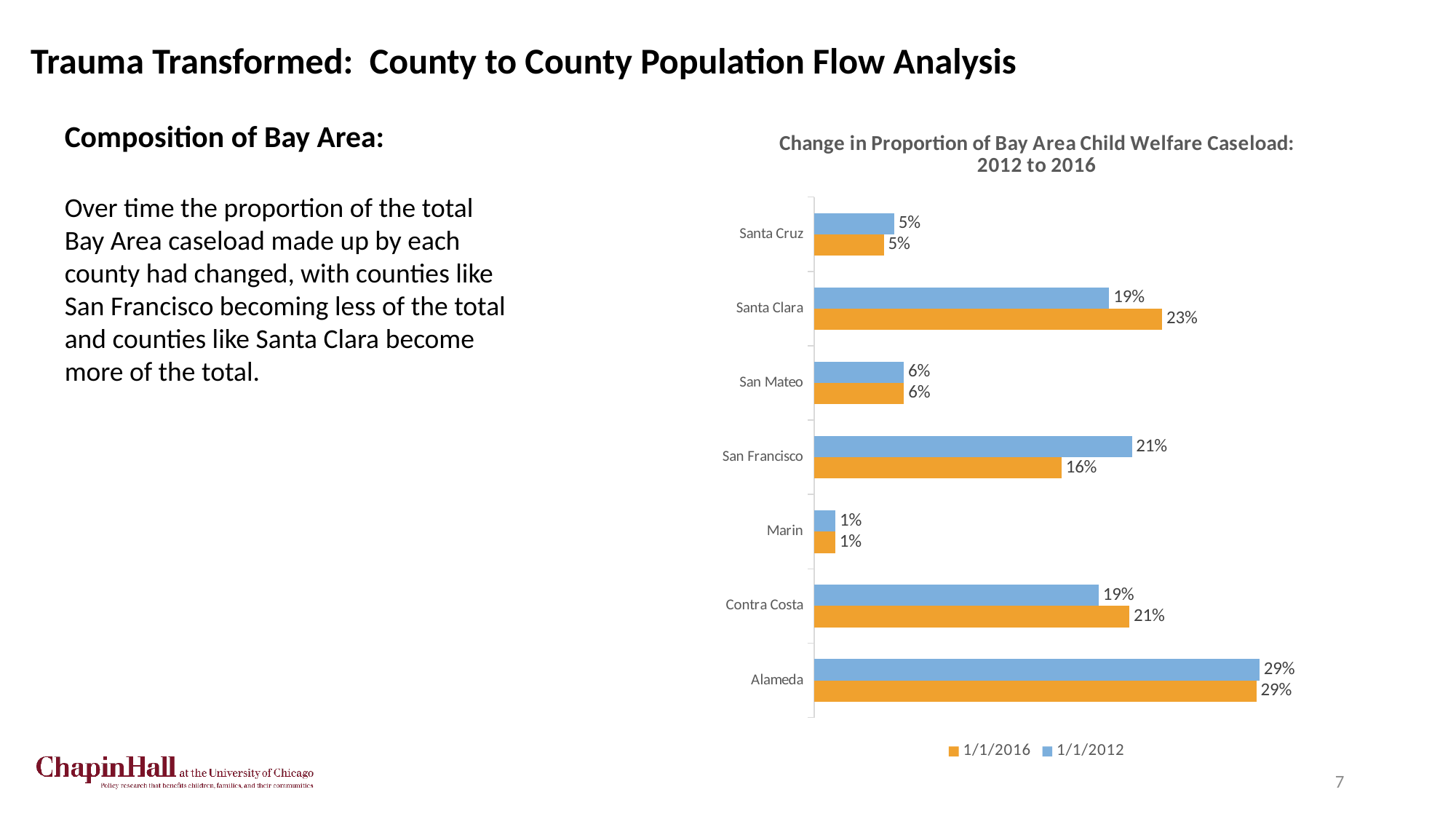
What is the 1/1/2016 value for Santa Clara? 23% How many counties are shown on the chart? 7 How many series does the legend list? 2 Which colour represents the 1/1/2016 series? Orange Which county has the lowest 1/1/2012 value? Marin Which county has the highest 1/1/2016 value? Alameda What kind of chart is shown on the slide? Bar chart What is the 1/1/2012 value for San Francisco? 21% What is the 1/1/2016 value for Contra Costa? 21% What is the difference between the 1/1/2012 and 1/1/2016 values for San Francisco? 5% What is the title of the chart? Change in Proportion of Bay Area Child Welfare Caseload: 2012 to 2016 Which is larger for Santa Clara: the 1/1/2012 value or the 1/1/2016 value? 1/1/2016